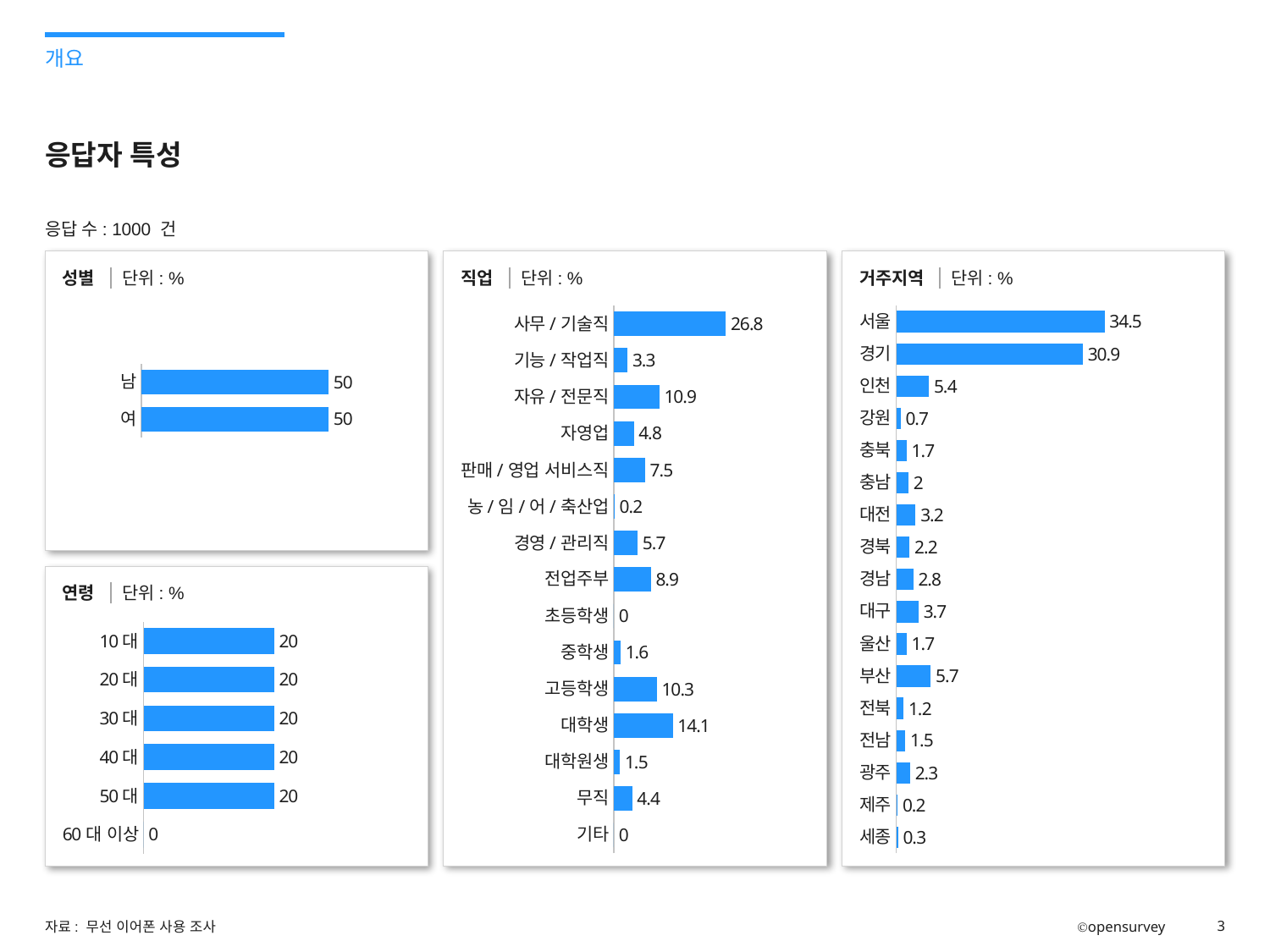
In the 거주지역 chart, what is the value for 인천? 5.4 In the 거주지역 chart, what is the difference between 서울 and 경기? 3.6 What kind of chart is the 성별 chart? bar chart In the 거주지역 chart, which region has the highest value? 서울 In the 직업 chart, what is the value for 사무 / 기술직? 26.8 How many regions are listed in the 거주지역 chart? 17 What unit is shown in the header of the 거주지역 chart? % In the 연령 chart, what is the value for 60 대 이상? 0 In the 직업 chart, which occupation has the lowest non-zero value? 농 / 임 / 어 / 축산업 How many categories are shown in the 연령 chart? 6 In the 직업 chart, what is the difference between 전업주부 and 자영업? 4.1 In the 직업 chart, which is larger, 대학생 or 고등학생? 대학생